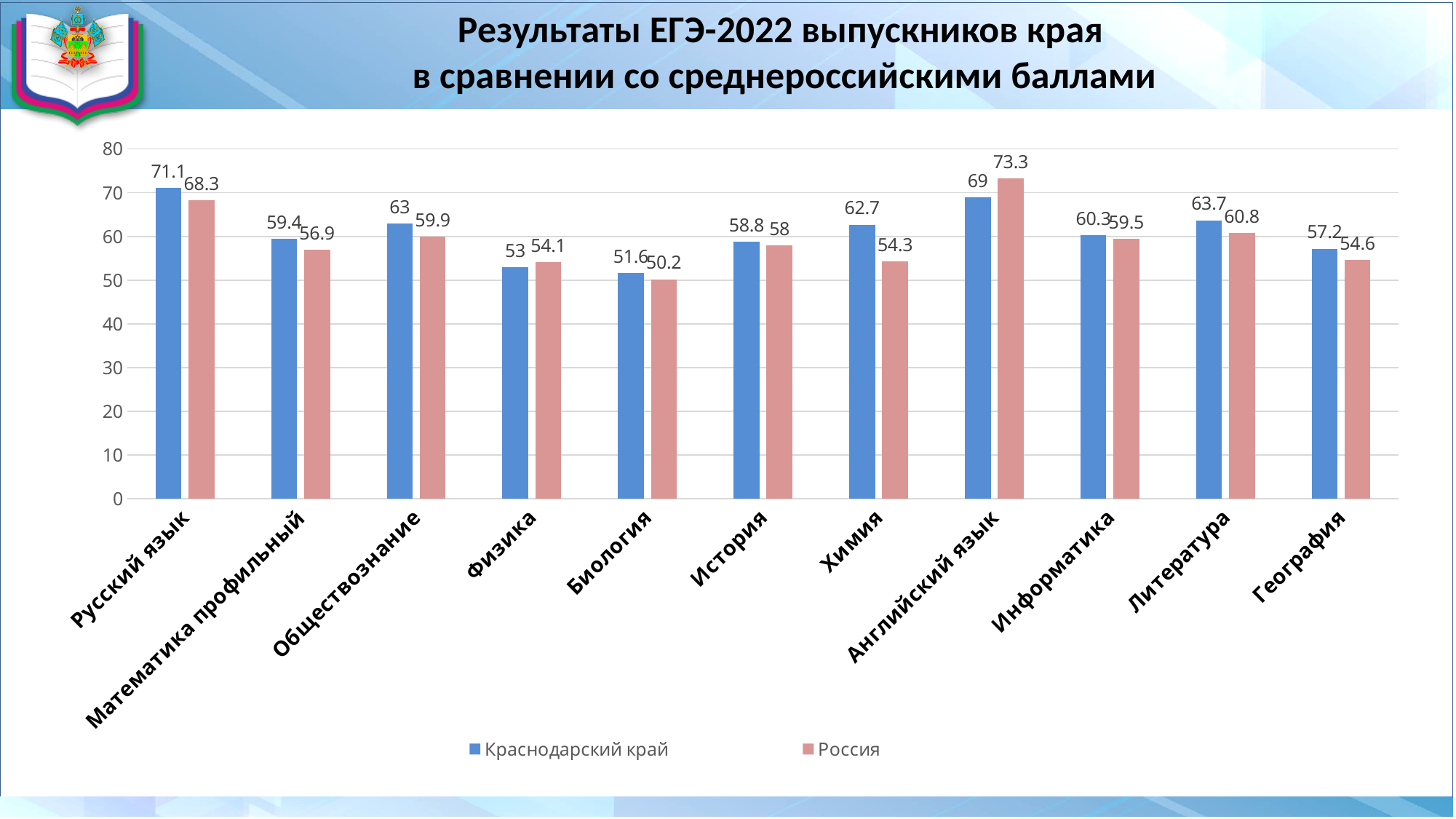
Which is larger in Физика: Краснодарский край or Россия? Россия What kind of chart is shown on the slide? bar chart What is the value for Краснодарский край in Биология? 51.6 What colour are the bars for Россия? pink What is the difference between Краснодарский край and Россия in Химия? 8.4 How many series does the legend list? 2 How many subjects are shown on the x axis? 11 What is the value for Краснодарский край in Русский язык? 71.1 Which subject has the highest value for Краснодарский край? Русский язык Is the value for Россия in География greater or less than 50? greater Which subject has the lowest value for Россия? Биология What is the value for Россия in Английский язык? 73.3